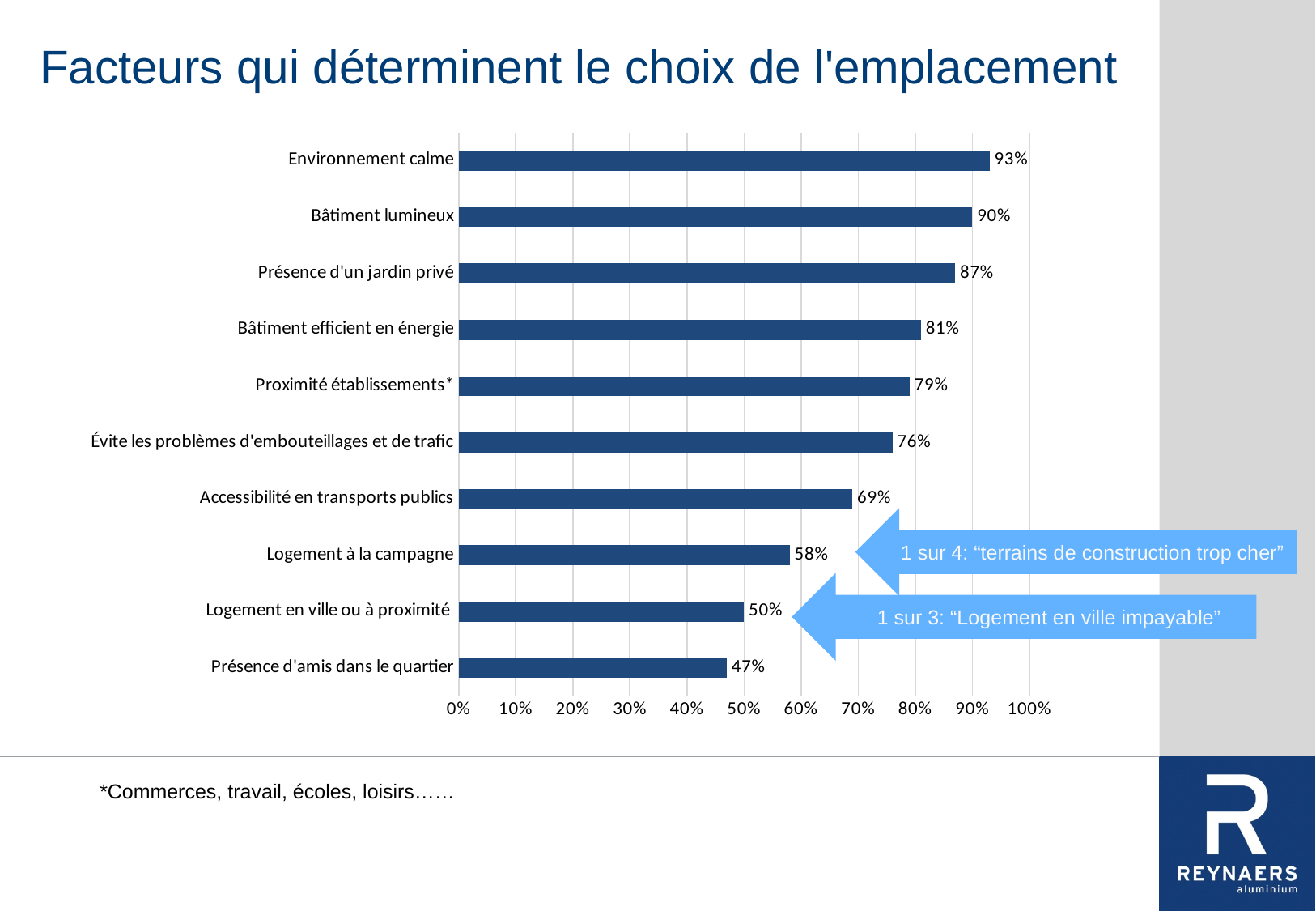
What is the title of the slide? Facteurs qui déterminent le choix de l'emplacement Is the value for Proximité établissements* greater or less than 70%? greater What is the value for Évite les problèmes d'embouteillages et de trafic? 76% What kind of chart is shown on the slide? bar chart Which is larger, the value for Présence d'un jardin privé or the value for Bâtiment efficient en énergie? Présence d'un jardin privé Which category has the lowest value? Présence d'amis dans le quartier What is the value for Accessibilité en transports publics? 69% What is the difference between the values for Bâtiment lumineux and Logement à la campagne? 32% How many categories are shown in the chart? 10 What is the value for Logement en ville ou à proximité? 50% What is the value for Environnement calme? 93% Which category has the highest value? Environnement calme